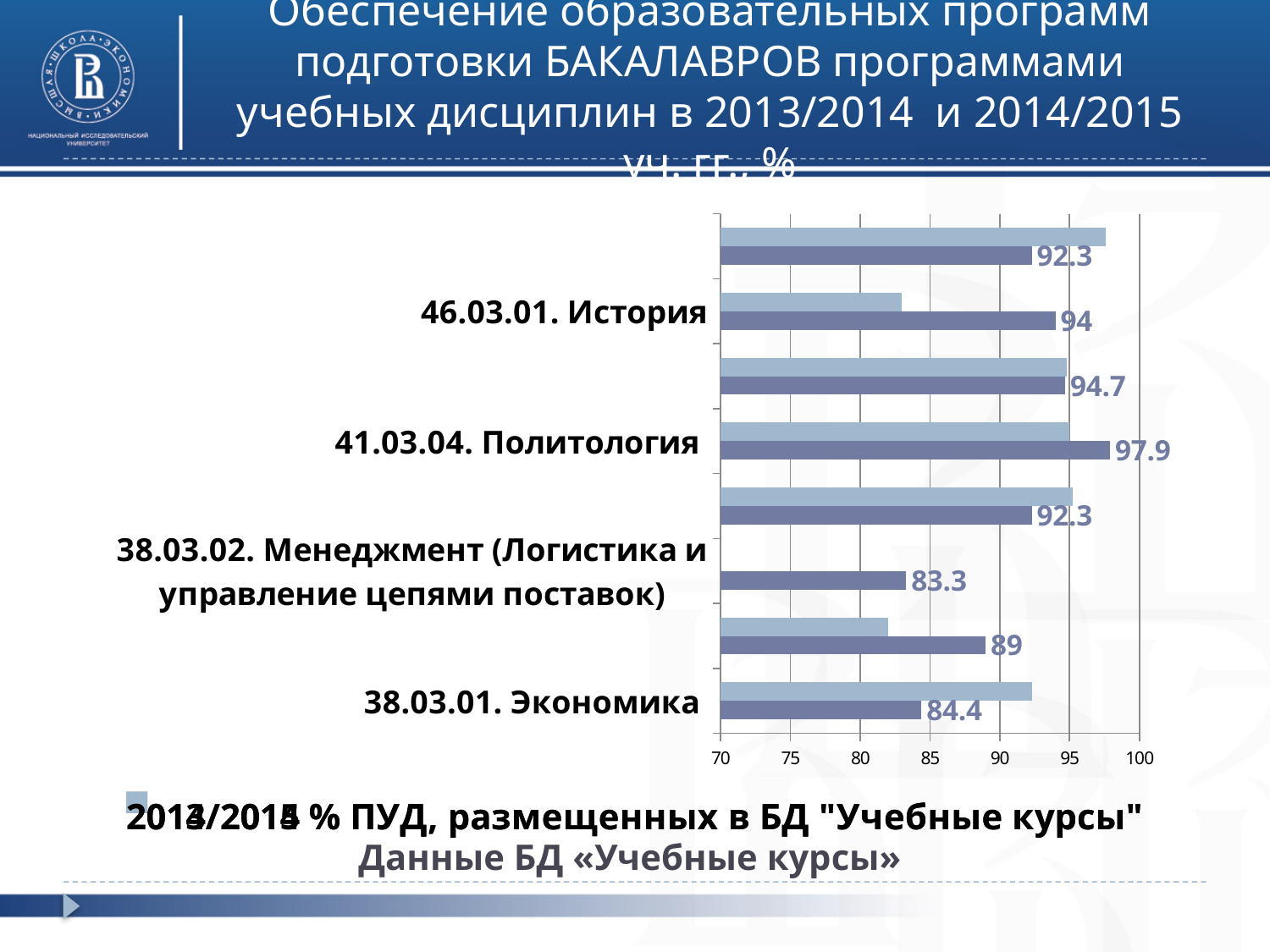
What is the maximum value shown on the horizontal axis? 100 Is the light blue bar for 46.03.01. История greater or less than 90? less Which has the larger dark blue bar value: 46.03.01. История or 38.03.01. Экономика? 46.03.01. История What is the value of the dark blue bar for 38.03.01. Экономика? 84.4 What is the value of the dark blue bar for 41.03.04. Политология? 97.9 For 38.03.01. Экономика, which bar is longer: the light blue bar or the dark blue bar? light blue What is the value of the dark blue bar for 38.03.02. Менеджмент (Логистика и управление цепями поставок)? 83.3 What type of chart is shown on the slide? bar chart Which labelled category has the lowest dark blue bar value? 38.03.02. Менеджмент (Логистика и управление цепями поставок) What is the value of the dark blue bar for 46.03.01. История? 94 Which labelled category has the highest dark blue bar value? 41.03.04. Политология What is the difference between the dark blue bar values for 41.03.04. Политология and 46.03.01. История? 3.9